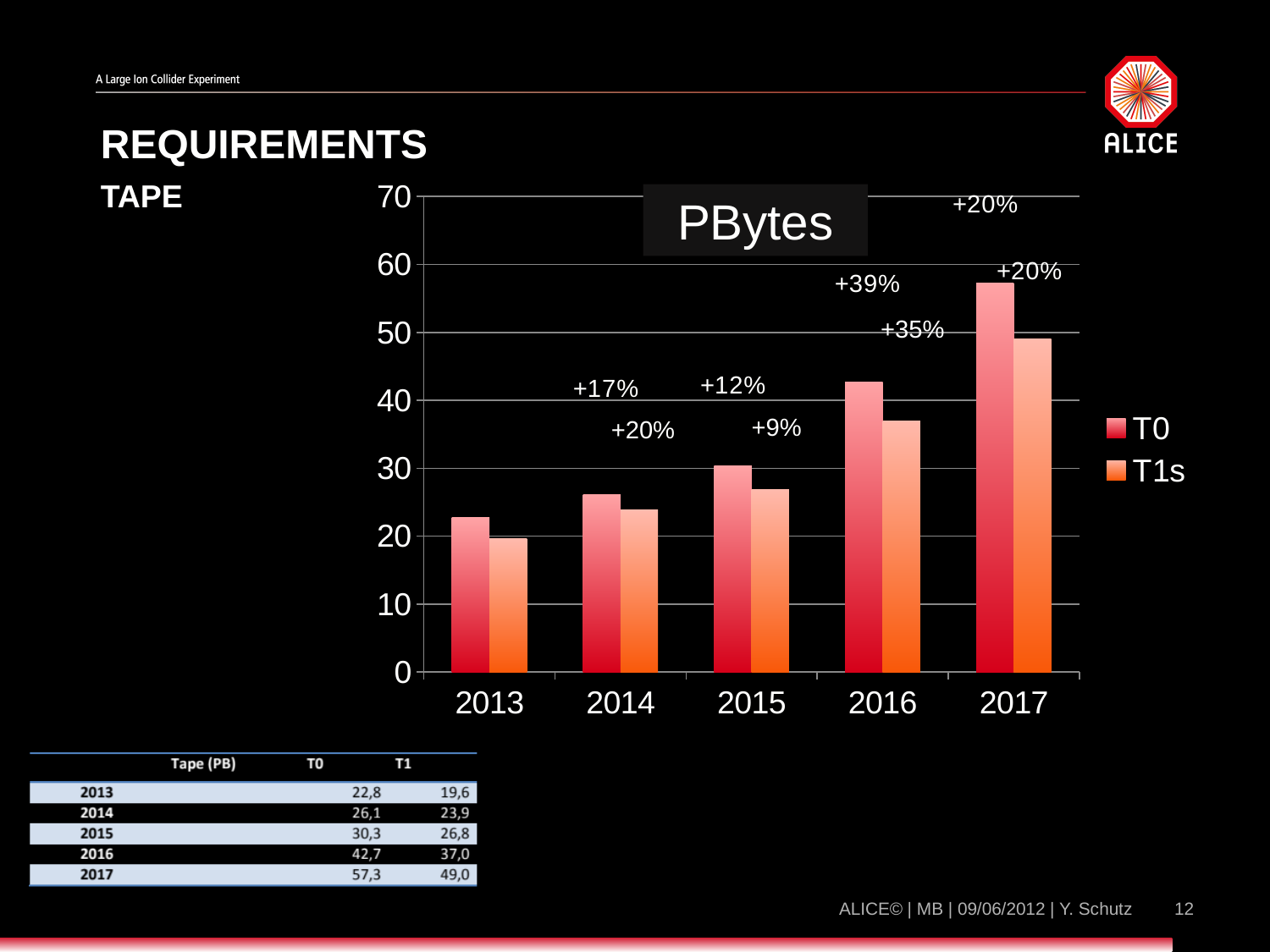
What unit label is shown in the box at the top of the chart? PBytes In which year is the T0 value highest? 2017 What is the difference between the T0 and T1 values in 2017? 8,3 How many years are shown on the x axis of the chart? 5 What is the T1 tape value for 2017? 49,0 In which year is the T1s value lowest? 2013 How many series does the chart legend list? 2 Is the T0 value for 2016 greater or less than 40? greater Do the T0 values rise or fall from 2013 to 2017? rise What is the T0 tape value for 2016? 42,7 In 2015, which series has the larger value, T0 or T1s? T0 What kind of chart is shown on the slide? bar chart